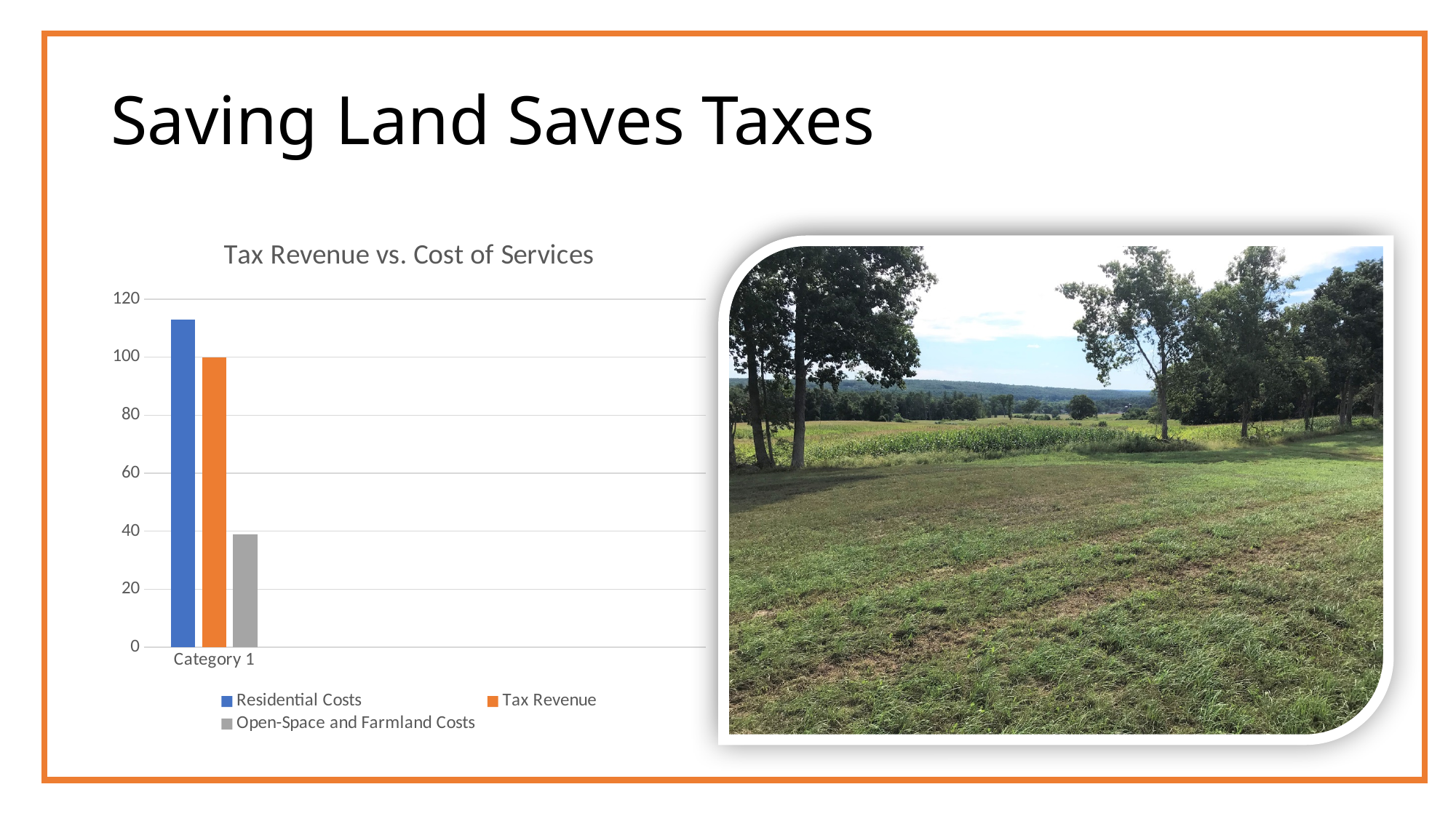
Which is larger, Tax Revenue or Open-Space and Farmland Costs? Tax Revenue Which series has the lowest value in the chart? Open-Space and Farmland Costs Is the value for Residential Costs greater or less than 100? greater How many categories are shown on the x axis of the chart? 1 What kind of chart is shown on the slide? bar chart Which series has the highest value in the chart? Residential Costs Is the value for Open-Space and Farmland Costs greater or less than 20? greater Is the value for Open-Space and Farmland Costs greater or less than 60? less Which is larger, Residential Costs or Tax Revenue? Residential Costs How many series does the chart legend list? 3 What is the title of the chart? Tax Revenue vs. Cost of Services Which colour represents Tax Revenue in the chart legend? orange